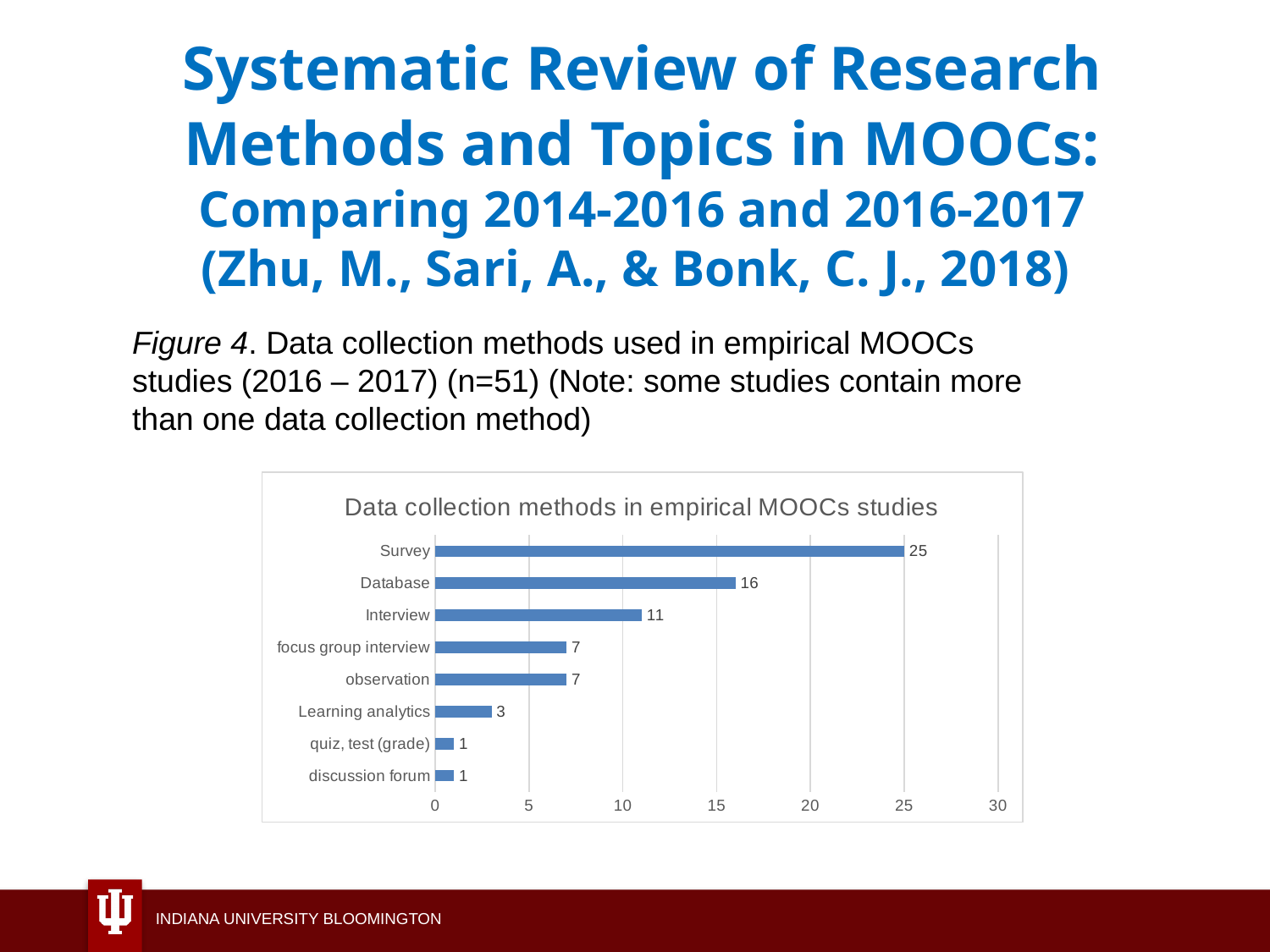
Is the value for Survey greater or less than 20? greater Which data collection method has the highest value? Survey What kind of chart is shown on the slide? bar chart What is the value for Interview? 11 What is the value for Database? 16 How many data collection methods are shown in the chart? 8 Which is larger, the value for Database or the value for Interview? Database What is the difference between the values for Interview and Learning analytics? 8 What is the value for Learning analytics? 3 What is the title of the chart? Data collection methods in empirical MOOCs studies What is the difference between the values for Survey and Database? 9 What is the value for Survey? 25